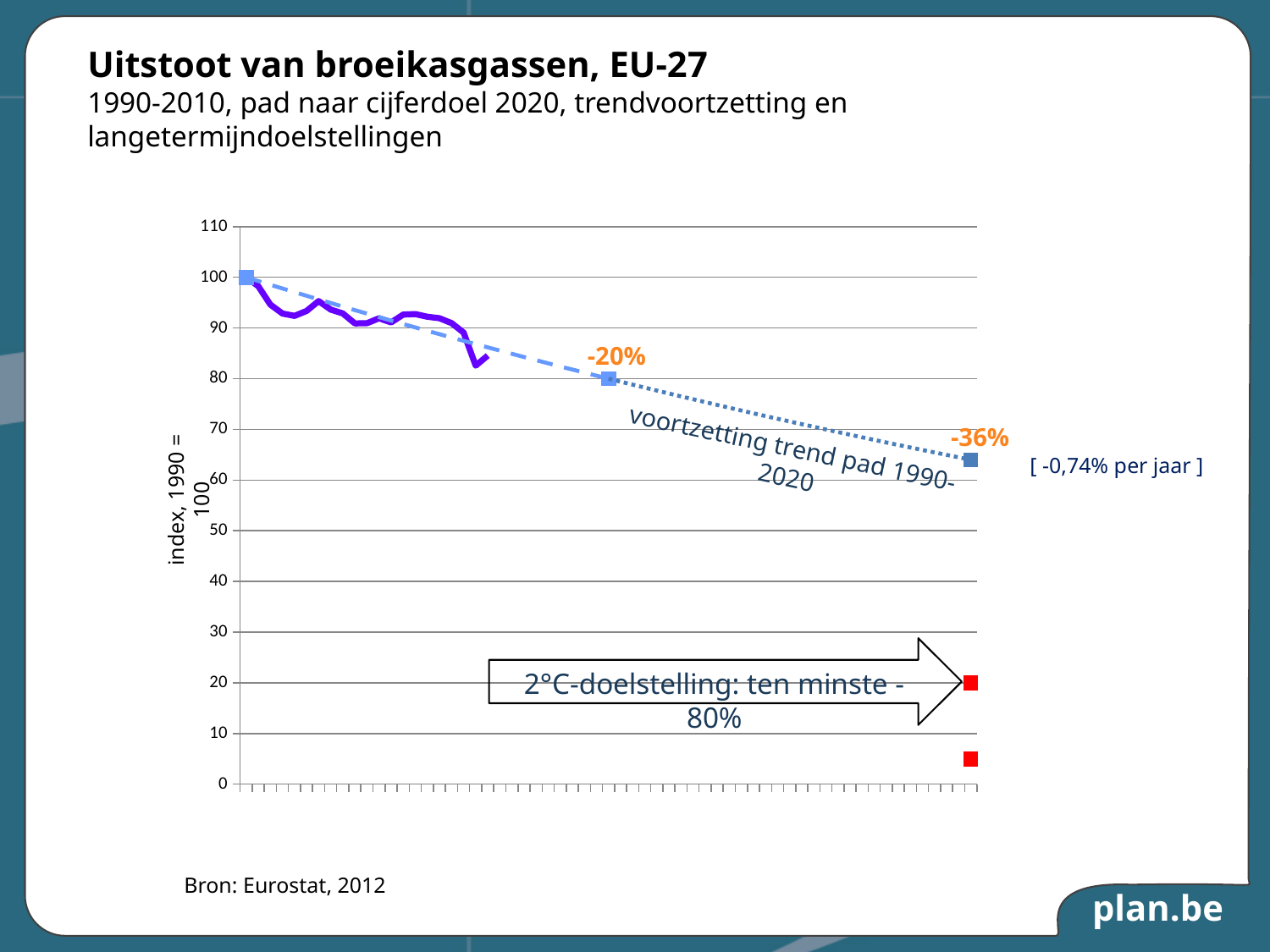
What kind of chart is shown on the slide? line chart What is the label on the vertical axis of the chart? index, 1990 = 100 What percentage label is printed at the end of the dotted trend-continuation line? -36% Does the purple line of actual emissions rise or fall overall from its start to its end? fall Is the value of the point labelled -36% greater or less than 70? less Is the value of the lower red square greater or less than 10? less What percentage label is printed at the end of the dashed blue path (the 2020 target point)? -20% What annual rate is given in brackets next to the end of the trend-continuation line? -0,74% per jaar Is the value at the end of the purple line greater or less than 90? less What is the title of the chart? Uitstoot van broeikasgassen, EU-27 What is the highest value shown on the vertical axis? 110